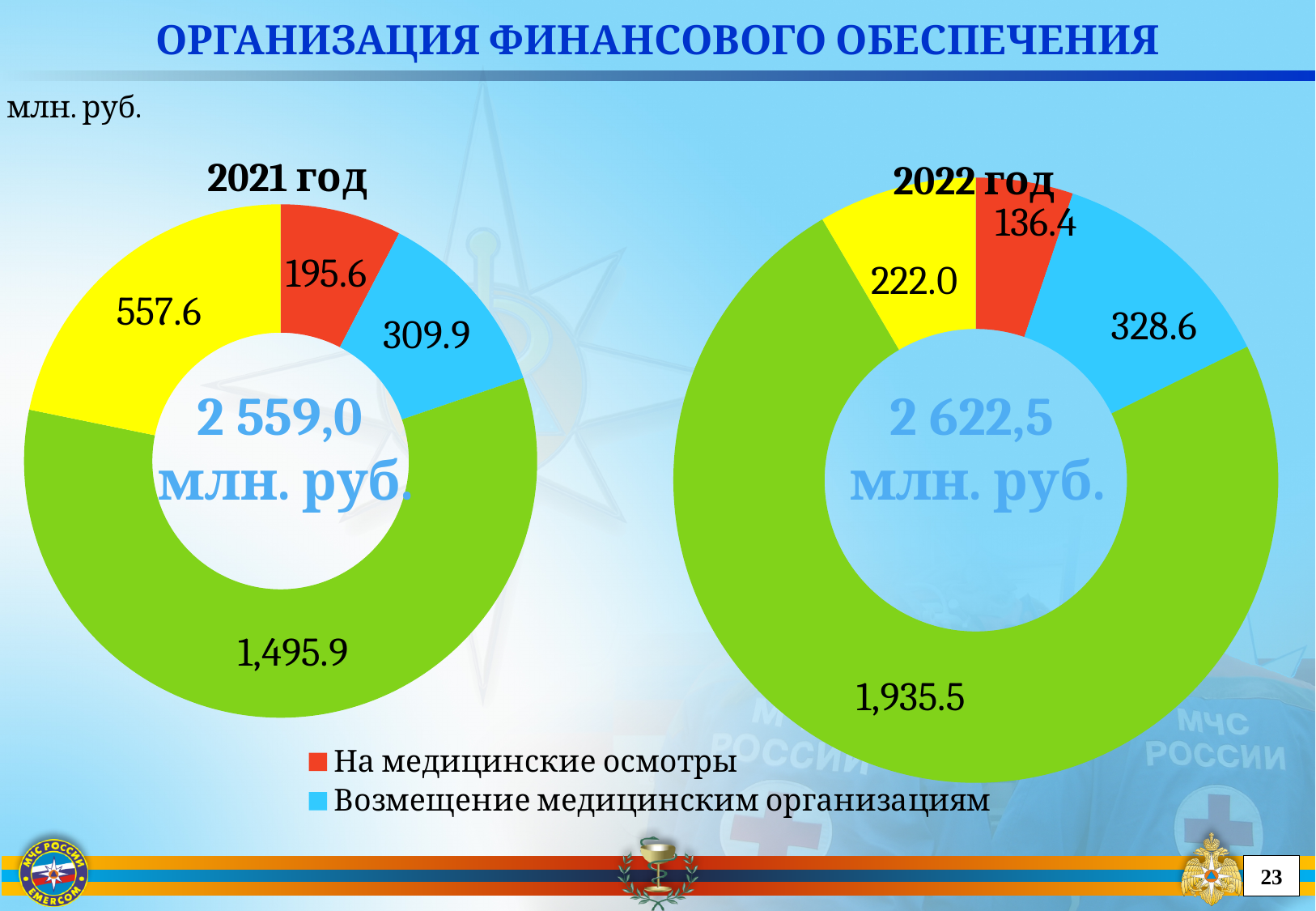
What total is printed in the centre of the 2022 год chart? 2 622,5 млн. руб. In the 2022 год chart, what is the value for Возмещение медицинским организациям? 328.6 How many entries does the legend list? 2 What total is printed in the centre of the 2021 год chart? 2 559,0 млн. руб. Which year has the larger value for На медицинские осмотры, 2021 год or 2022 год? 2021 год In the 2022 год chart, what value is labelled on the largest slice? 1,935.5 What kind of chart is used for the 2021 год data? pie (doughnut) chart By how much did Возмещение медицинским организациям increase from the 2021 год chart to the 2022 год chart? 18.7 In the 2021 год chart, what is the value for На медицинские осмотры? 195.6 In the 2022 год chart, which legend category is the smallest slice? На медицинские осмотры How many slices does the 2022 год chart have? 4 What colour represents На медицинские осмотры in the charts? red